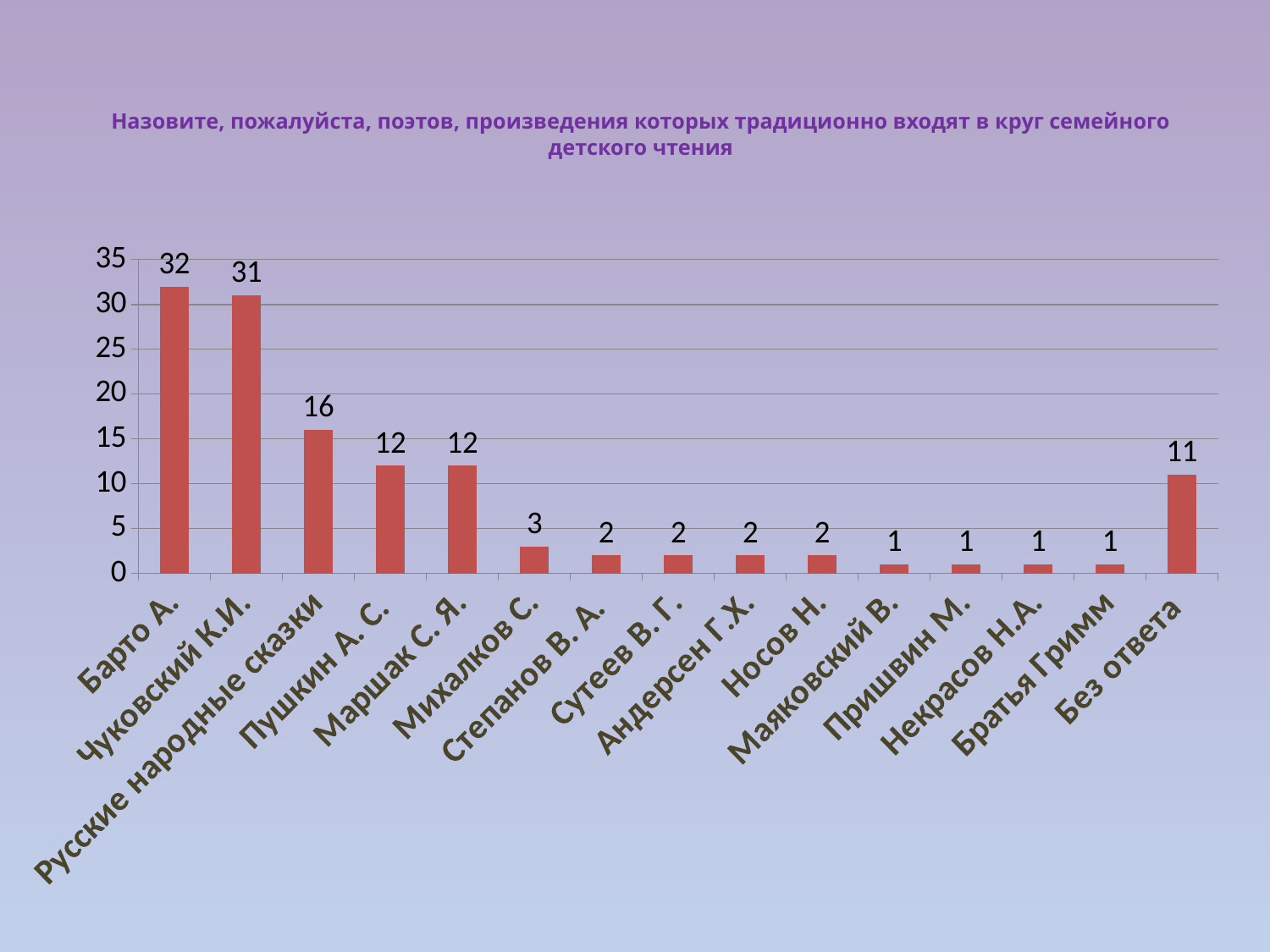
Which is larger, the value for Пушкин А. С. or the value for Без ответа? Пушкин А. С. What kind of chart is shown on the slide? bar chart What is the difference between the values for Русские народные сказки and Без ответа? 5 What value is shown for Маршак С. Я.? 12 What value is shown for Барто А.? 32 Is the value for Чуковский К.И. greater or less than 25? greater What value is shown for Без ответа? 11 What value is shown for Русские народные сказки? 16 How many categories are shown on the x axis? 15 What value is shown for Михалков С.? 3 What is the difference between the values for Барто А. and Чуковский К.И.? 1 Which category has the highest value? Барто А.